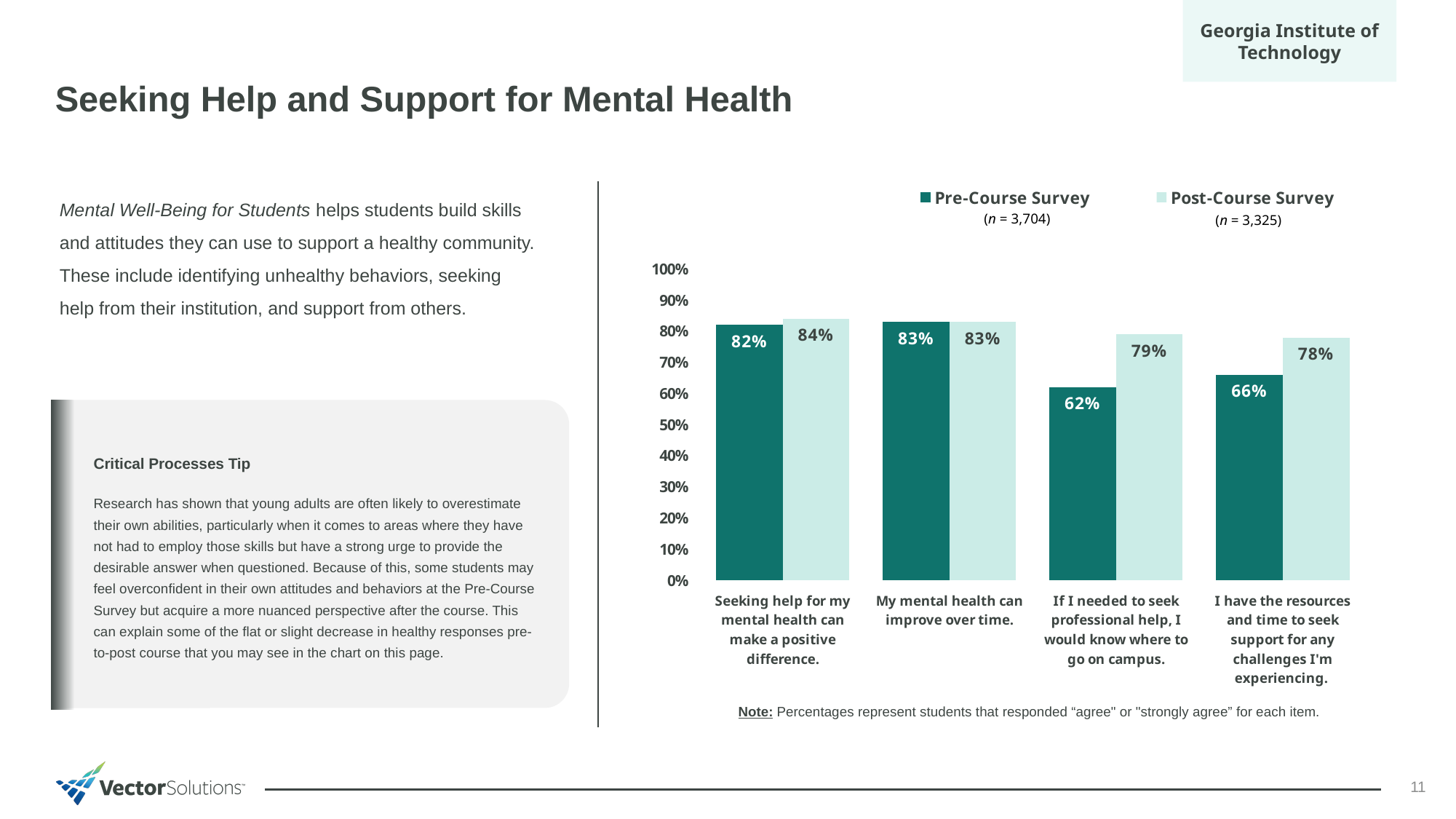
What is the sample size (n) for the Pre-Course Survey shown in the legend? 3,704 What is the Post-Course Survey value for "Seeking help for my mental health can make a positive difference."? 84% What is the difference between the Post-Course and Pre-Course Survey values for "If I needed to seek professional help, I would know where to go on campus."? 17% How many items (categories) are shown on the x axis of the chart? 4 How many series does the chart legend list? 2 What is the Post-Course Survey value for "I have the resources and time to seek support for any challenges I'm experiencing."? 78% Which is larger for "My mental health can improve over time.": the Pre-Course Survey value or the Post-Course Survey value? They are equal (83%) What kind of chart is shown on the slide? Bar chart What is the difference between the Post-Course and Pre-Course Survey values for "I have the resources and time to seek support for any challenges I'm experiencing."? 12% What is the Pre-Course Survey value for "If I needed to seek professional help, I would know where to go on campus."? 62% Which item has the highest Post-Course Survey value? Seeking help for my mental health can make a positive difference. Which item has the lowest Pre-Course Survey value? If I needed to seek professional help, I would know where to go on campus.